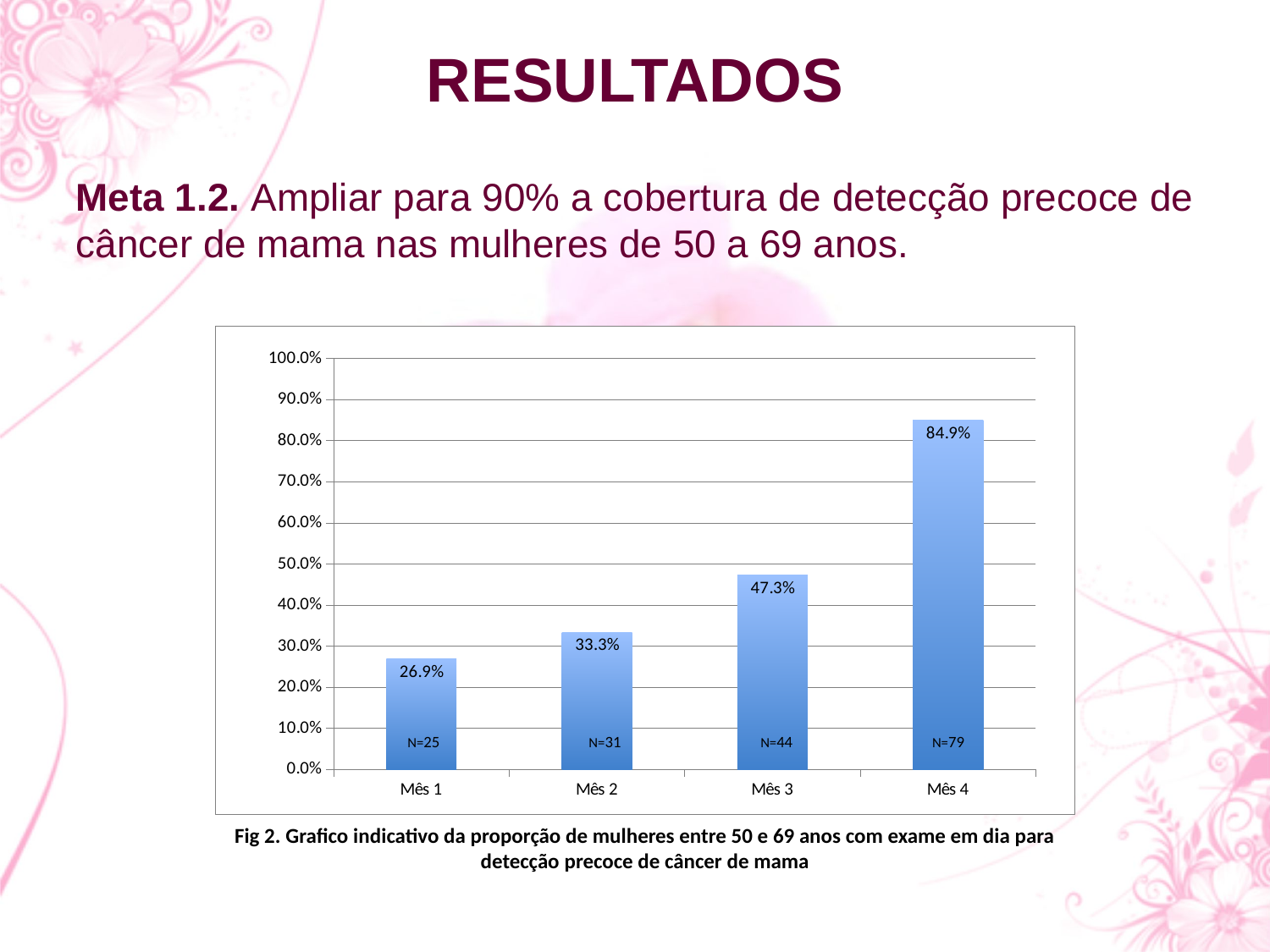
Which month has the highest value? Mês 4 What is the difference between the values for Mês 4 and Mês 3? 37.6% What kind of chart is shown? bar chart How many months are shown on the x axis? 4 What is the value for Mês 4? 84.9% Is the value for Mês 4 greater or less than 90.0%? less Which is larger, the value for Mês 2 or the value for Mês 3? Mês 3 What is the difference between the values for Mês 2 and Mês 1? 6.4% Do the values rise or fall from Mês 1 to Mês 4? rise What is the value for Mês 1? 26.9% What is the value for Mês 3? 47.3% Which month has the lowest value? Mês 1